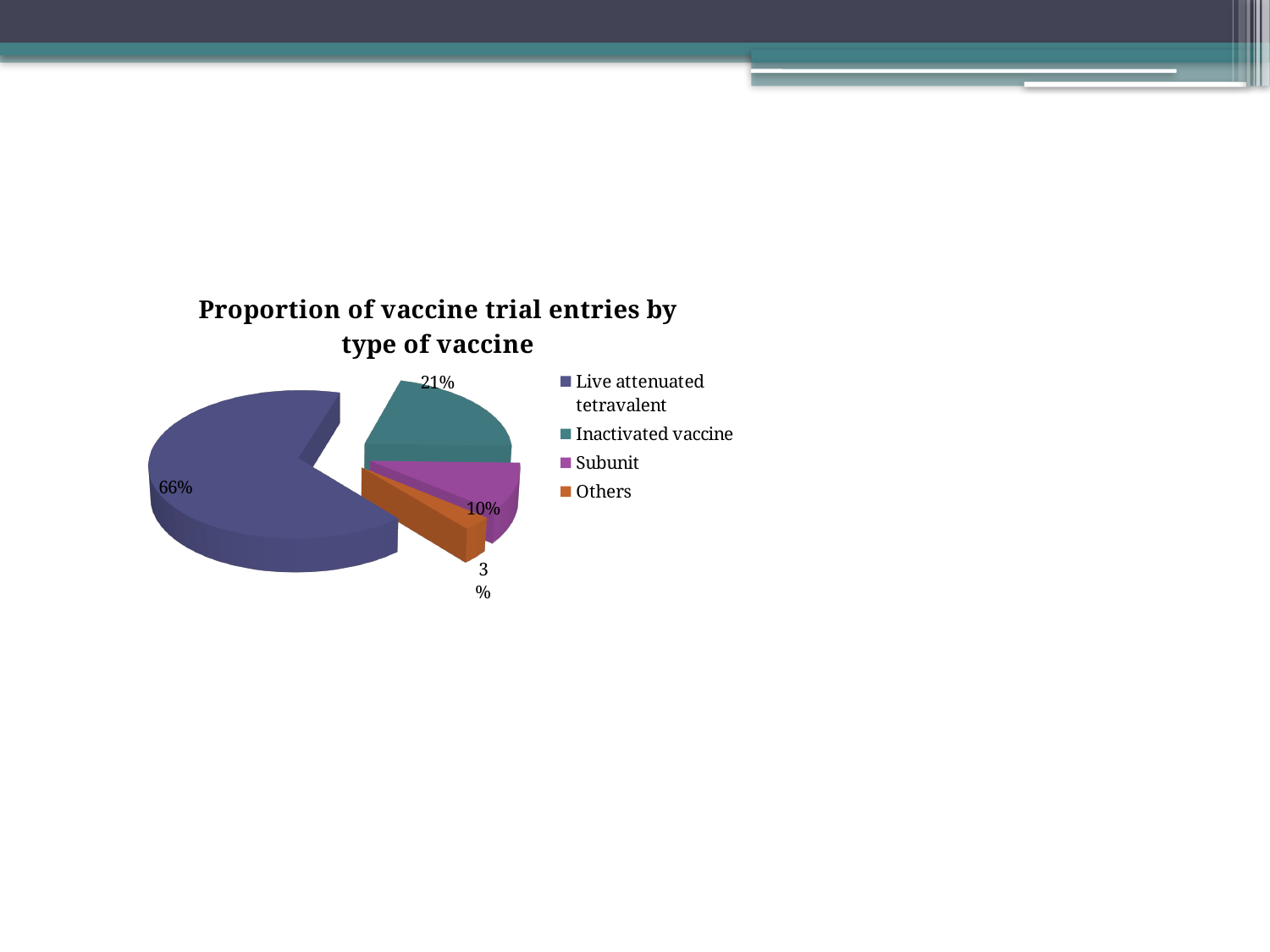
What is the difference in percentage points between Live attenuated tetravalent and Inactivated vaccine? 45 What type of chart is shown on the slide? Pie chart Which vaccine type has the smallest share of the pie? Others What share of the pie does Live attenuated tetravalent represent? 66% Which has a larger share, Subunit or Inactivated vaccine? Inactivated vaccine Which vaccine type has the largest share of the pie? Live attenuated tetravalent What share of the pie does Inactivated vaccine represent? 21% What is the title of the chart? Proportion of vaccine trial entries by type of vaccine How many categories does the pie chart have? 4 What colour is the slice for Others? Orange What share of the pie does Others represent? 3%